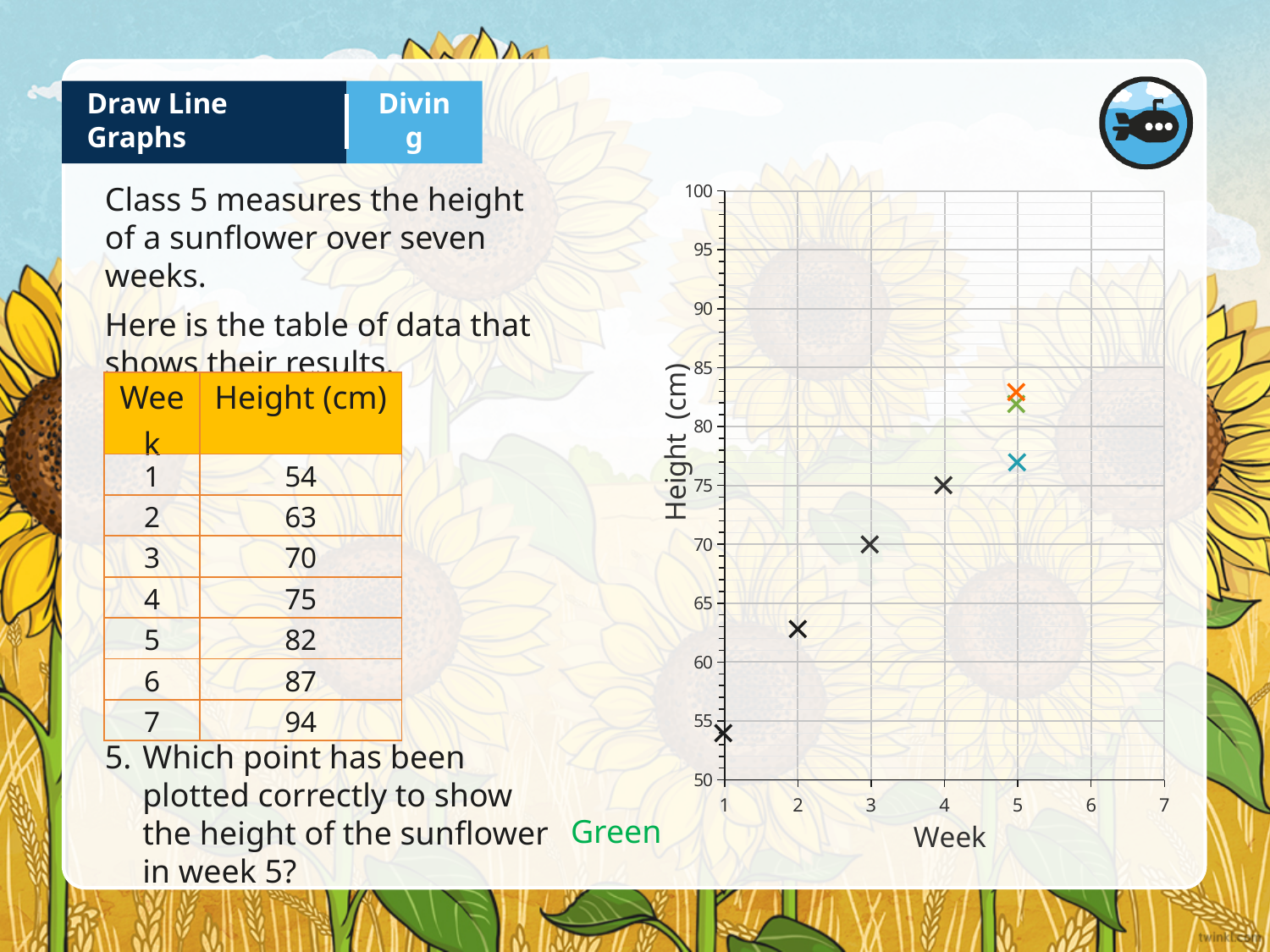
Is the plotted value for week 2 greater or less than 65? less How many black crosses are plotted on the chart? 4 Do the plotted heights rise or fall as the weeks increase? rise Is the plotted value for week 1 greater or less than 55? less What height is plotted on the chart for week 4? 75 What is the label on the horizontal axis of the chart? Week Is the green point plotted at week 5 greater or less than 80? greater Of the three points plotted at week 5, which colour is the lowest? blue How many points are plotted at week 5 on the chart? 3 What is the label on the vertical axis of the chart? Height (cm) What height is plotted on the chart for week 3? 70 Which is higher on the chart, the point for week 3 or the point for week 4? week 4